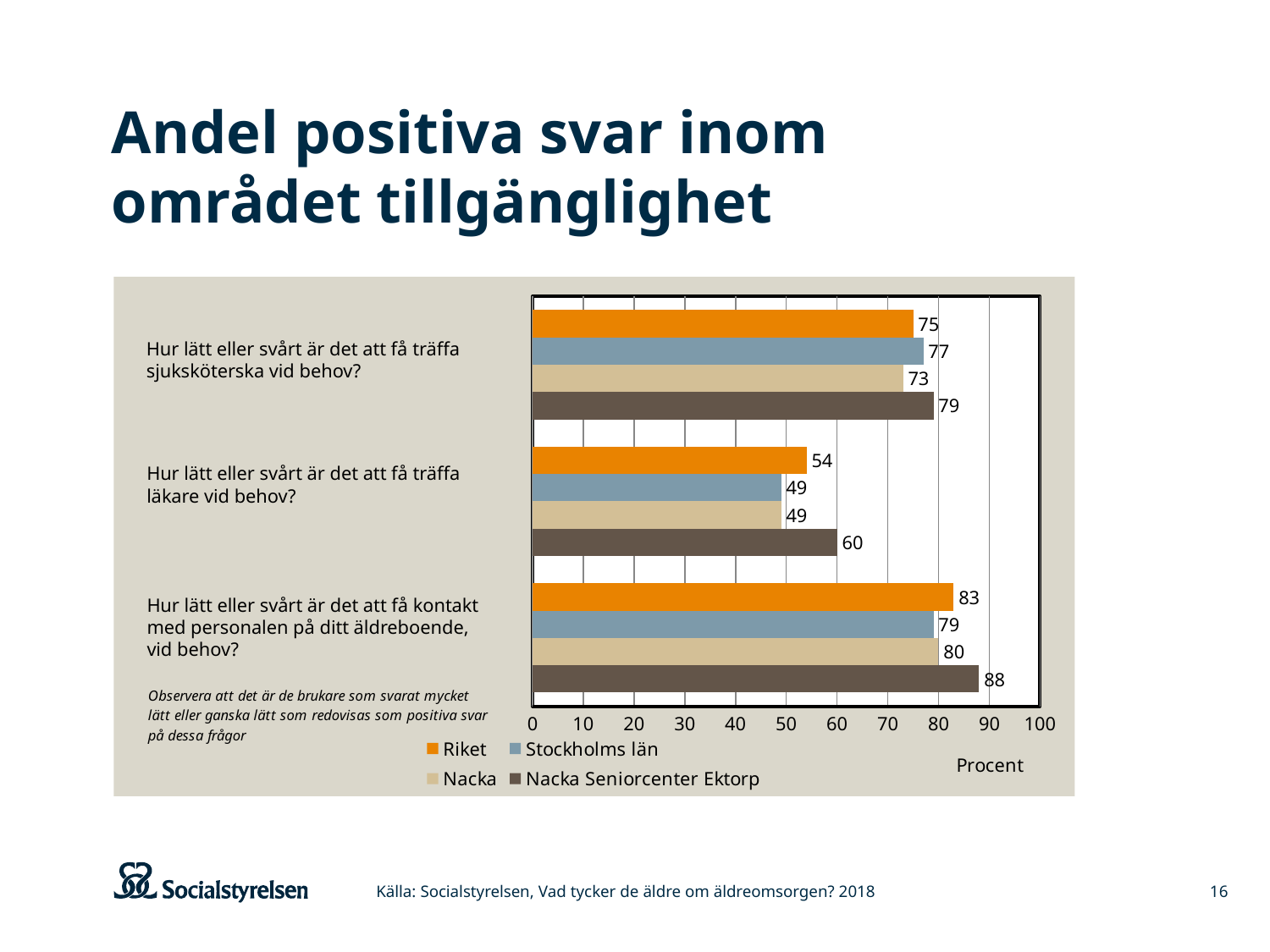
What is the value for Nacka Seniorcenter Ektorp for the question "Hur lätt eller svårt är det att få träffa läkare vid behov?"? 60 What kind of chart is shown on the slide? bar chart Which series has the lowest value for the question "Hur lätt eller svårt är det att få träffa sjuksköterska vid behov?"? Nacka What is the difference between the Nacka Seniorcenter Ektorp value and the Riket value for the question "Hur lätt eller svårt är det att få träffa läkare vid behov?"? 6 Is the value for Nacka Seniorcenter Ektorp for the question "Hur lätt eller svårt är det att få kontakt med personalen på ditt äldreboende, vid behov?" greater or less than 80? greater What is the value for Stockholms län for the question "Hur lätt eller svårt är det att få kontakt med personalen på ditt äldreboende, vid behov?"? 79 For the question "Hur lätt eller svårt är det att få träffa sjuksköterska vid behov?", which is larger: the value for Stockholms län or the value for Nacka? Stockholms län Which series has the highest value for the question "Hur lätt eller svårt är det att få kontakt med personalen på ditt äldreboende, vid behov?"? Nacka Seniorcenter Ektorp How many questions (categories) are shown on the chart? 3 What is the label of the horizontal axis? Procent What is the value for Riket for the question "Hur lätt eller svårt är det att få träffa sjuksköterska vid behov?"? 75 How many series does the legend list? 4